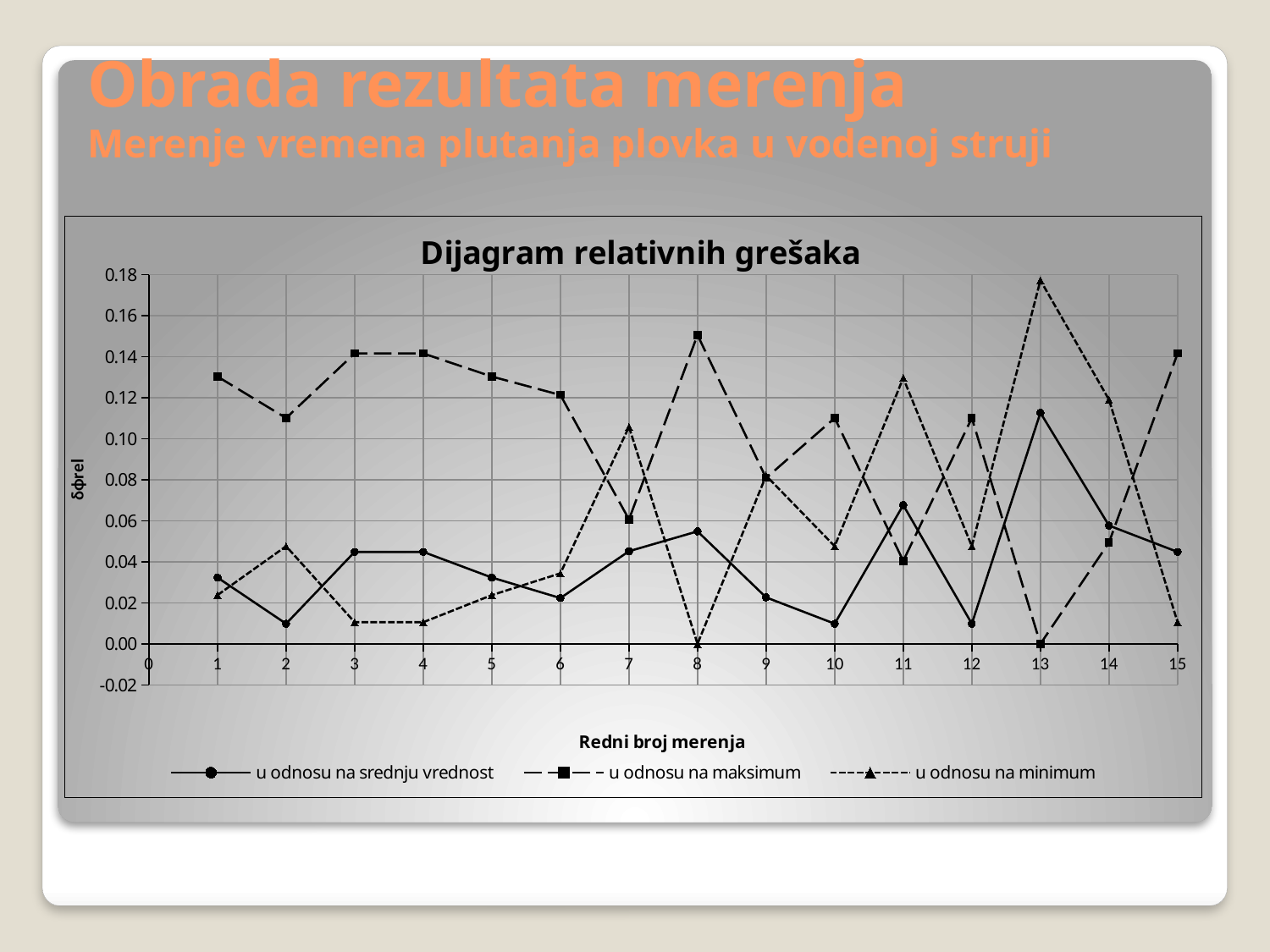
What kind of chart is shown on the slide? line chart Is the value of 'u odnosu na maksimum' at measurement 1 greater or less than 0.10? greater At which measurement number does the series 'u odnosu na minimum' reach its highest value? 13 Is the value of 'u odnosu na minimum' at measurement 13 greater or less than 0.16? greater What is the title of the chart? Dijagram relativnih grešaka What is the label of the x axis? Redni broj merenja Is the value of 'u odnosu na srednju vrednost' at measurement 13 greater or less than 0.08? greater How many series does the legend list? 3 At measurement 8, which series has the larger value: 'u odnosu na maksimum' or 'u odnosu na minimum'? u odnosu na maksimum At which measurement number does the series 'u odnosu na maksimum' reach its lowest value? 13 How many measurements (points per series) are plotted along the x axis? 15